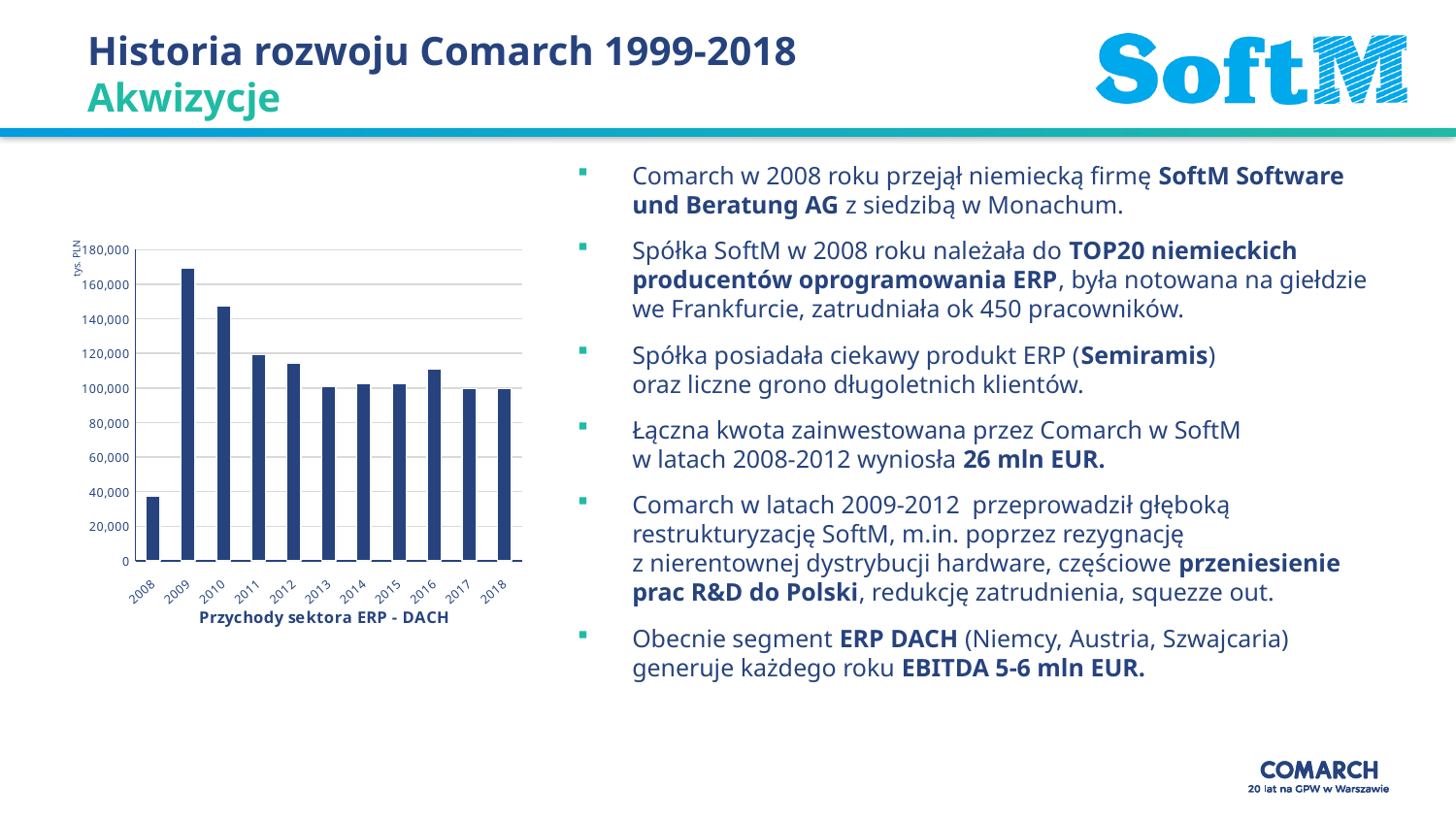
Do the values rise or fall from 2009 to 2013? fall Is the value for 2009 greater or less than 160,000? greater What kind of chart is shown on the slide? bar chart What unit is shown on the vertical axis of the chart? tys. PLN Is the value for 2008 greater or less than 40,000? less How many years are shown on the x axis of the chart? 11 Is the value for 2010 greater or less than 140,000? greater Which year has the larger value, 2009 or 2010? 2009 What is the title of the chart? Przychody sektora ERP - DACH Which year has the lowest value in the chart? 2008 Which year has the highest value in the chart? 2009